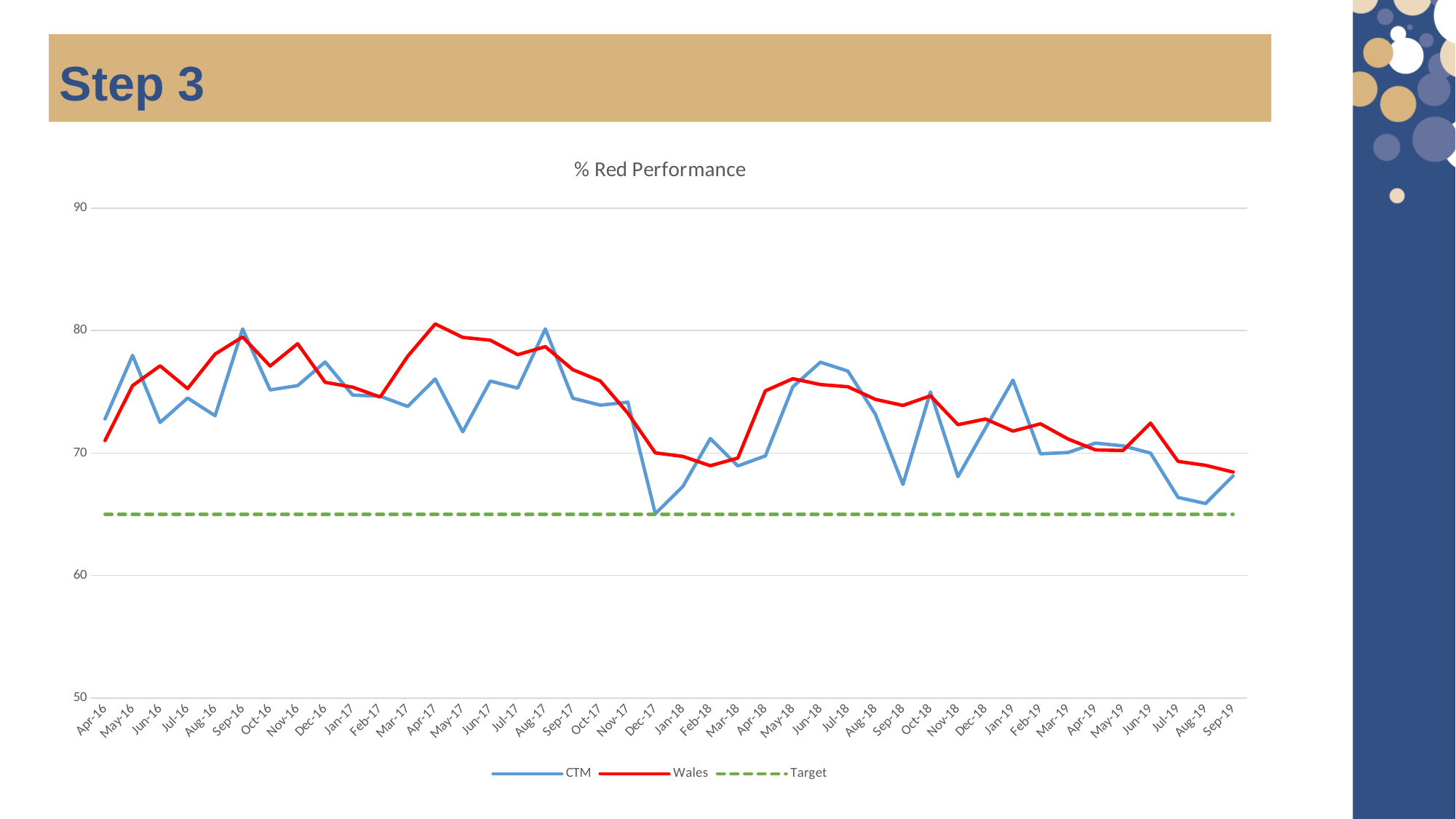
What is the title of the chart? % Red Performance Is the Wales value for Sep-19 greater or less than 70? less How many series does the chart legend list? 3 In which month does the CTM series reach its lowest value? Dec-17 Is the Target line greater or less than 70? less In Jan-19, which series has the higher value, CTM or Wales? CTM What type of chart is shown on the slide? Line chart Is the CTM value for Sep-18 greater or less than 70? less Which series in the chart is drawn as a dashed line? Target In Dec-17, which series has the higher value, CTM or Wales? Wales How many months are plotted along the x axis of the chart? 42